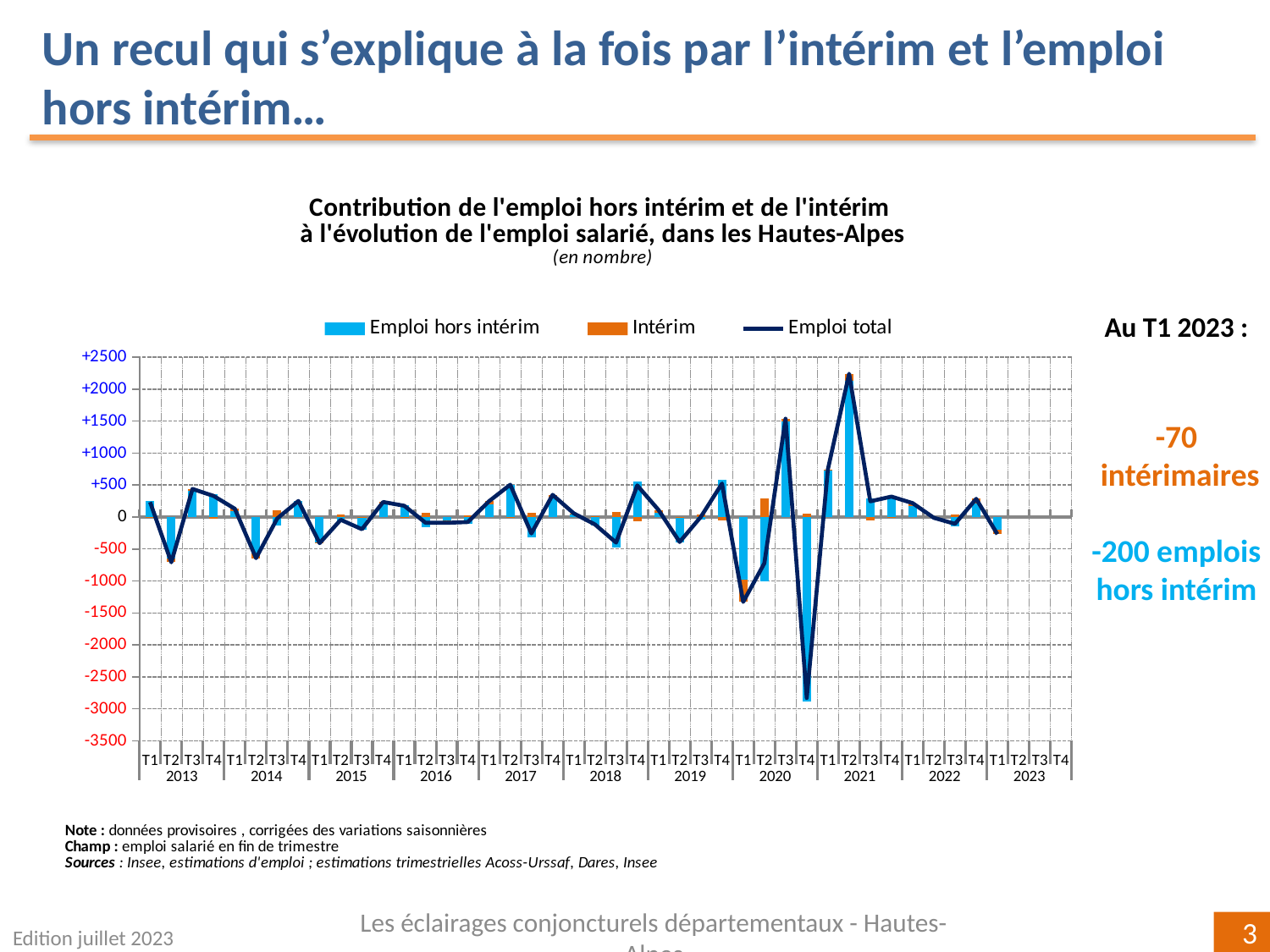
Is the Emploi total value at T2 2021 greater or less than +2000? greater Which series is drawn as a line rather than bars? Emploi total In which quarter does the Emploi total line reach its lowest value? T4 2020 Is the Emploi total value at T1 2020 greater or less than -1000? less Is the Emploi total value at T4 2020 greater or less than -2500? less According to the slide, what is the contribution of intérim at T1 2023? -70 intérimaires Which is larger, the Emploi total value at T2 2021 or at T3 2020? T2 2021 According to the slide, what is the contribution of emploi hors intérim at T1 2023? -200 emplois hors intérim In which quarter does the Emploi total line reach its highest value? T2 2021 How many series does the legend list? 3 How many years are labelled along the x axis? 11 What kind of chart is shown on the slide? A combined bar and line chart